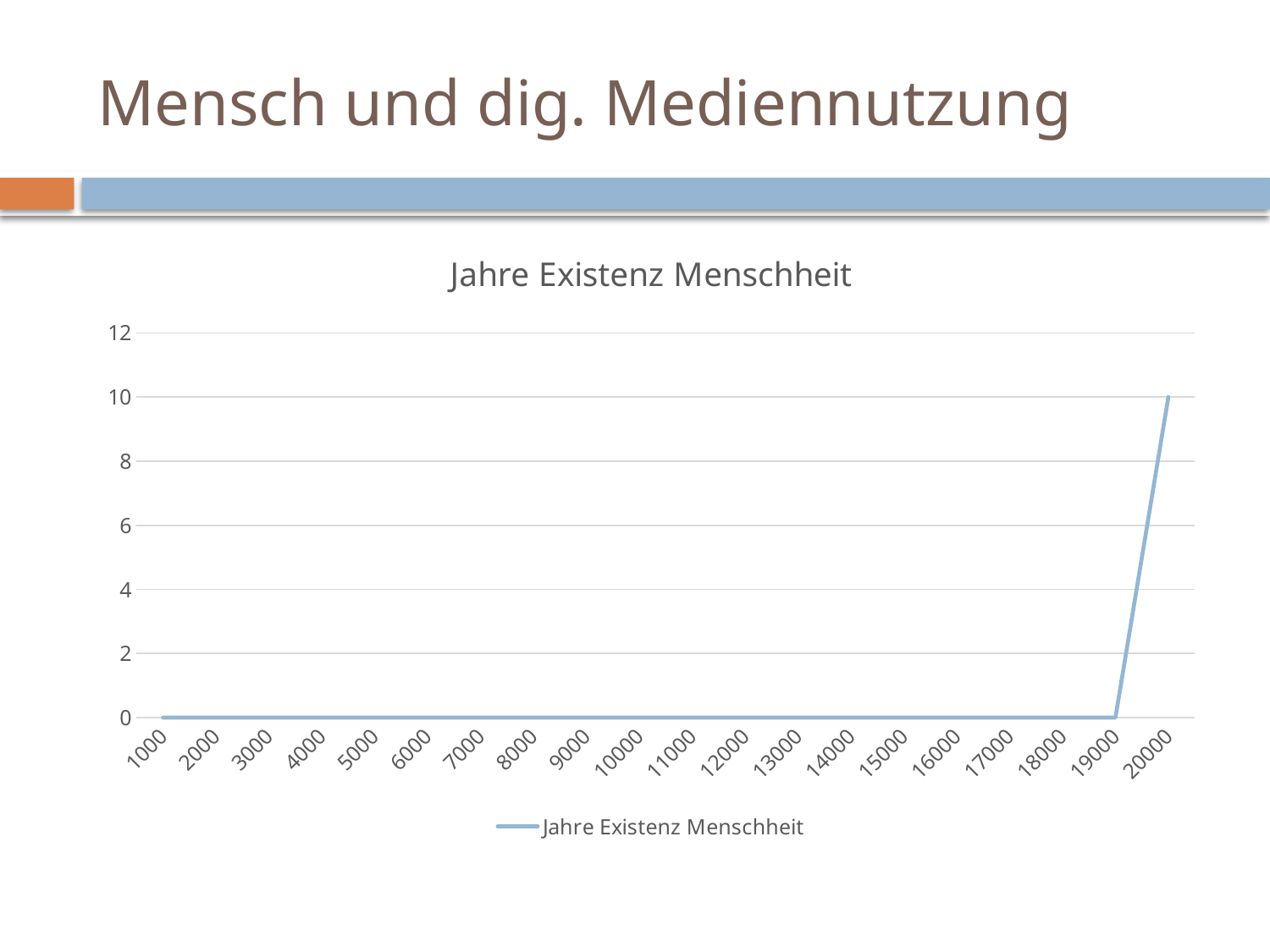
What is the title of the chart? Jahre Existenz Menschheit How many points are plotted along the x axis? 20 What is the value at 1000? 0 What is the difference between the value at 20000 and the value at 19000? 10 At which x-axis category is the value highest? 20000 Does the line rise or fall between 19000 and 20000? rise Which is larger, the value at 18000 or the value at 20000? 20000 What is the value at 20000? 10 Is the value at 20000 greater or less than 8? greater What is the value at 19000? 0 How many series does the legend list? 1 What kind of chart is shown on the slide? line chart